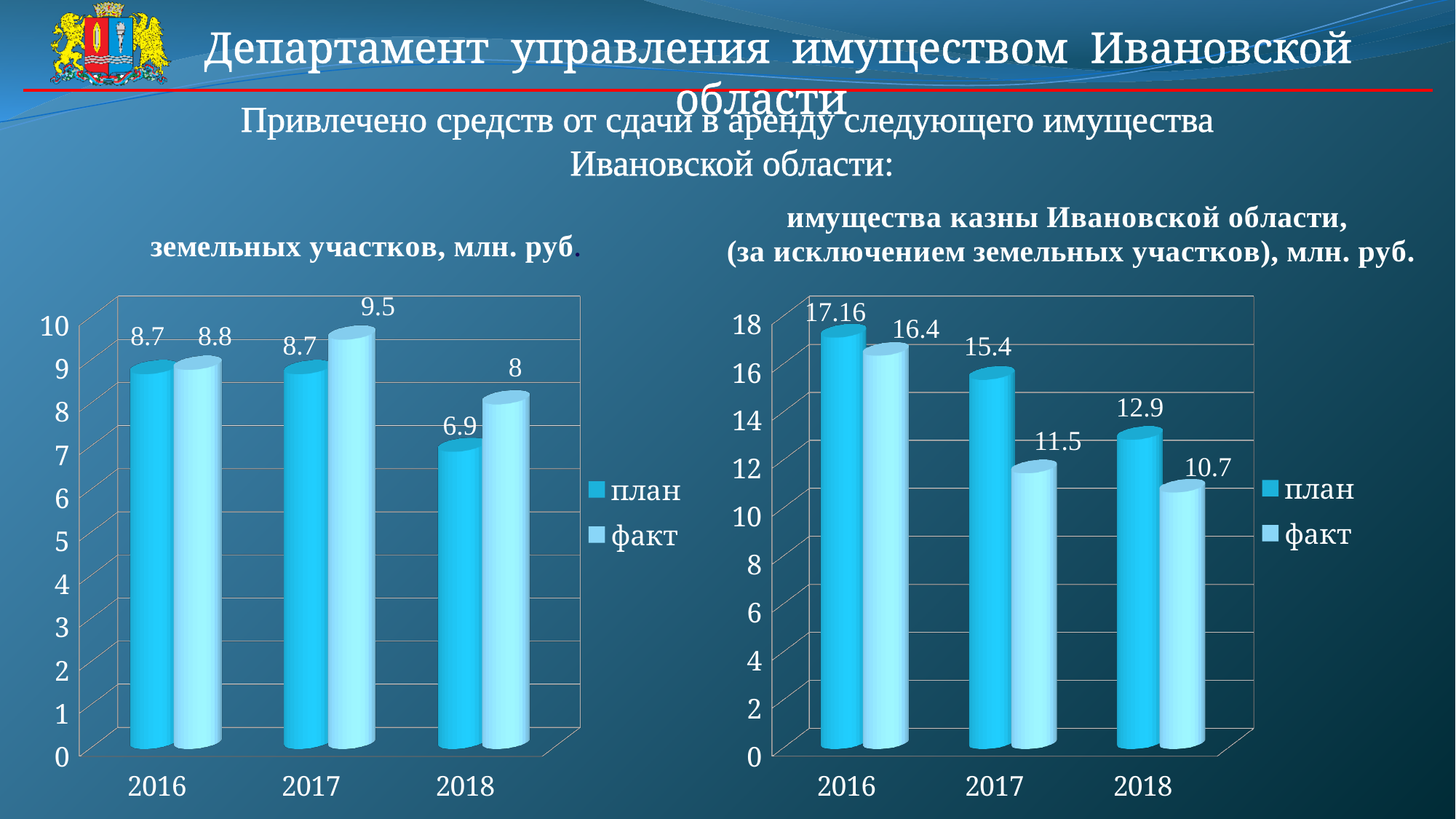
In the right chart (имущества казны Ивановской области), what is the difference between the план and факт values for 2017? 3.9 In the left chart (земельных участков, млн. руб.), what is the факт value for 2018? 8 In the right chart (имущества казны Ивановской области), what is the факт value for 2017? 11.5 In the left chart (земельных участков, млн. руб.), how many years are shown on the x axis? 3 In the right chart (имущества казны Ивановской области), which year has the lowest факт value? 2018 In the left chart (земельных участков, млн. руб.), what is the план value for 2017? 8.7 In the left chart (земельных участков, млн. руб.), which year has the highest факт value? 2017 In the right chart (имущества казны Ивановской области), is the план value for 2018 larger or the факт value for 2018? план How many series does the legend of the left chart (земельных участков, млн. руб.) list? 2 In the left chart (земельных участков, млн. руб.), what is the difference between the факт and план values for 2017? 0.8 In the right chart (имущества казны Ивановской области), do the план values rise or fall from 2016 to 2018? fall In the right chart (имущества казны Ивановской области), what is the план value for 2016? 17.16